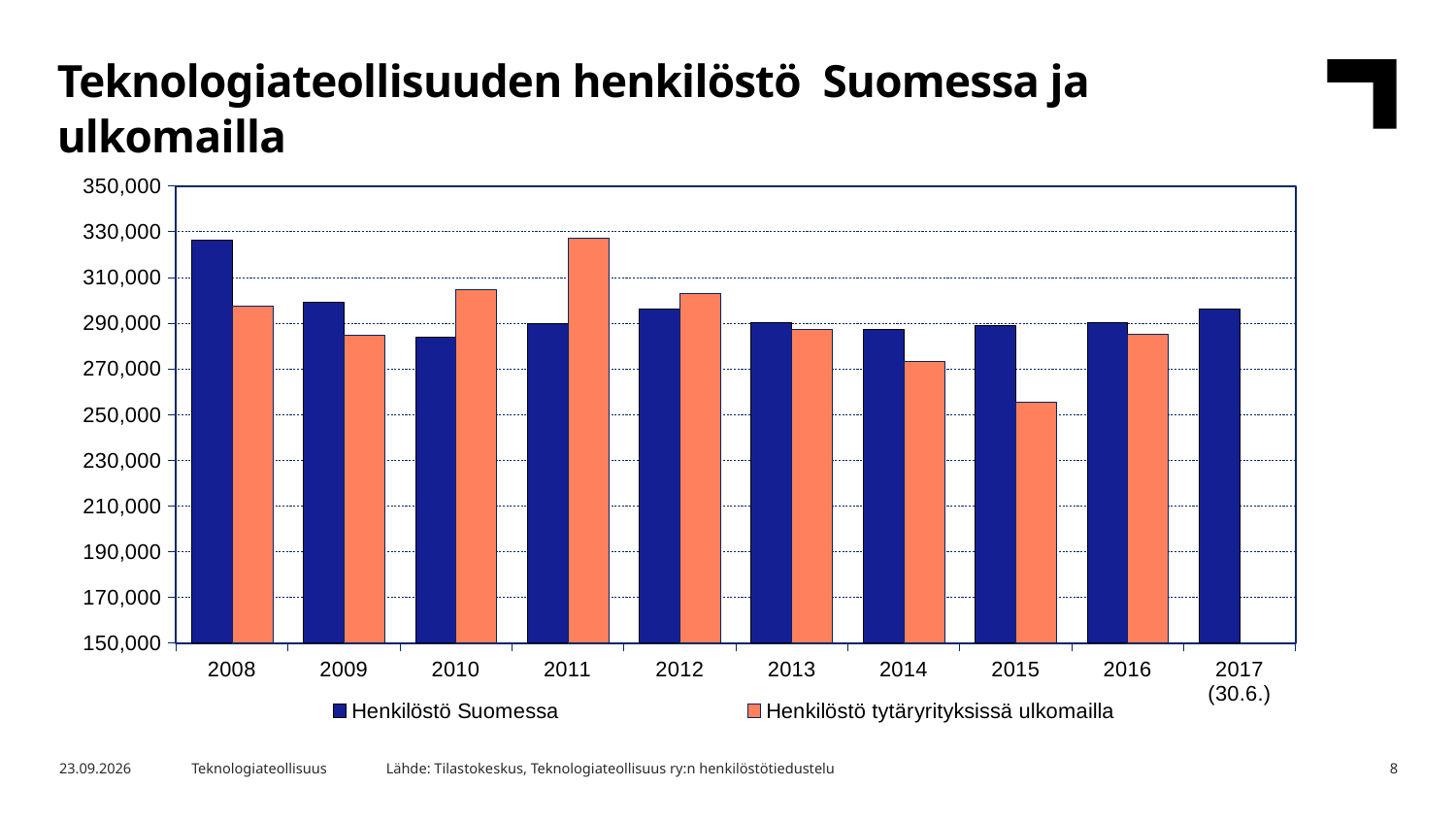
Which year has the highest value for Henkilöstö tytäryrityksissä ulkomailla? 2011 In 2011, which is larger: Henkilöstö Suomessa or Henkilöstö tytäryrityksissä ulkomailla? Henkilöstö tytäryrityksissä ulkomailla Which year has the lowest value for Henkilöstö tytäryrityksissä ulkomailla? 2015 Is the value for Henkilöstö Suomessa in 2008 greater or less than 310,000? greater Does the value for Henkilöstö tytäryrityksissä ulkomailla rise or fall from 2011 to 2015? fall In 2015, which is larger: Henkilöstö Suomessa or Henkilöstö tytäryrityksissä ulkomailla? Henkilöstö Suomessa Is the value for Henkilöstö tytäryrityksissä ulkomailla in 2014 greater or less than 290,000? less What kind of chart is shown on the slide? bar chart How many years are shown on the x axis? 10 How many series does the legend list? 2 Is the value for Henkilöstö tytäryrityksissä ulkomailla in 2015 greater or less than 270,000? less Which year has the highest value for Henkilöstö Suomessa? 2008